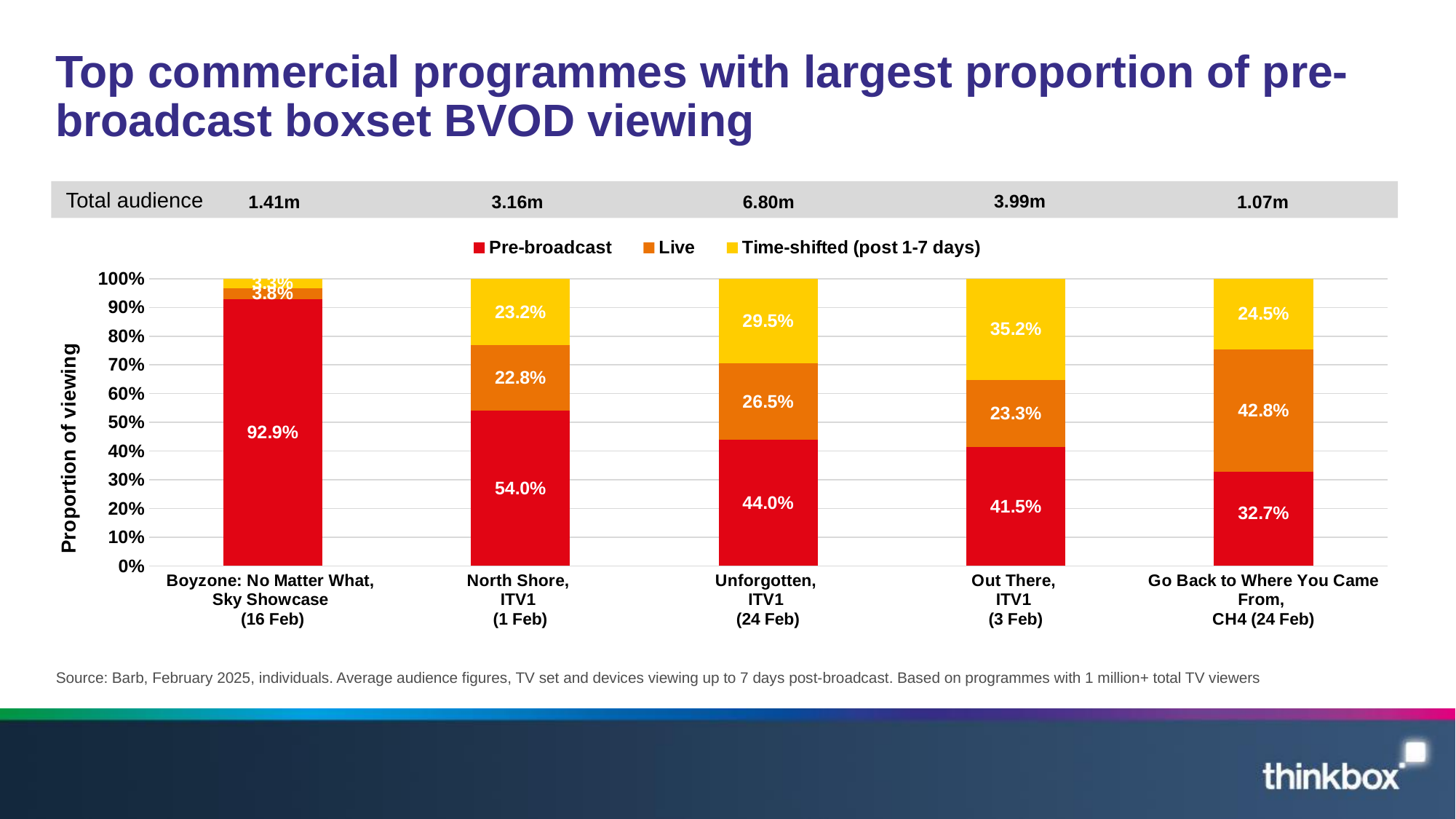
Which programme has the highest Pre-broadcast share of viewing? Boyzone: No Matter What, Sky Showcase (16 Feb) What is the Time-shifted (post 1-7 days) share of viewing for Out There, ITV1 (3 Feb)? 35.2% What kind of chart is shown on the slide? Stacked bar chart How many series does the legend list? 3 Which programme has the lowest Pre-broadcast share of viewing? Go Back to Where You Came From, CH4 (24 Feb) What is the Pre-broadcast share of viewing for Unforgotten, ITV1 (24 Feb)? 44.0% What is the Live share of viewing for Go Back to Where You Came From, CH4 (24 Feb)? 42.8% What is the total audience shown for Unforgotten, ITV1 (24 Feb)? 6.80m What is the difference between the Pre-broadcast shares of North Shore and Unforgotten? 10.0% How many programmes are shown on the chart? 5 Which is larger: the Live share for Unforgotten or the Live share for Out There? Unforgotten What is the Pre-broadcast share of viewing for North Shore, ITV1 (1 Feb)? 54.0%